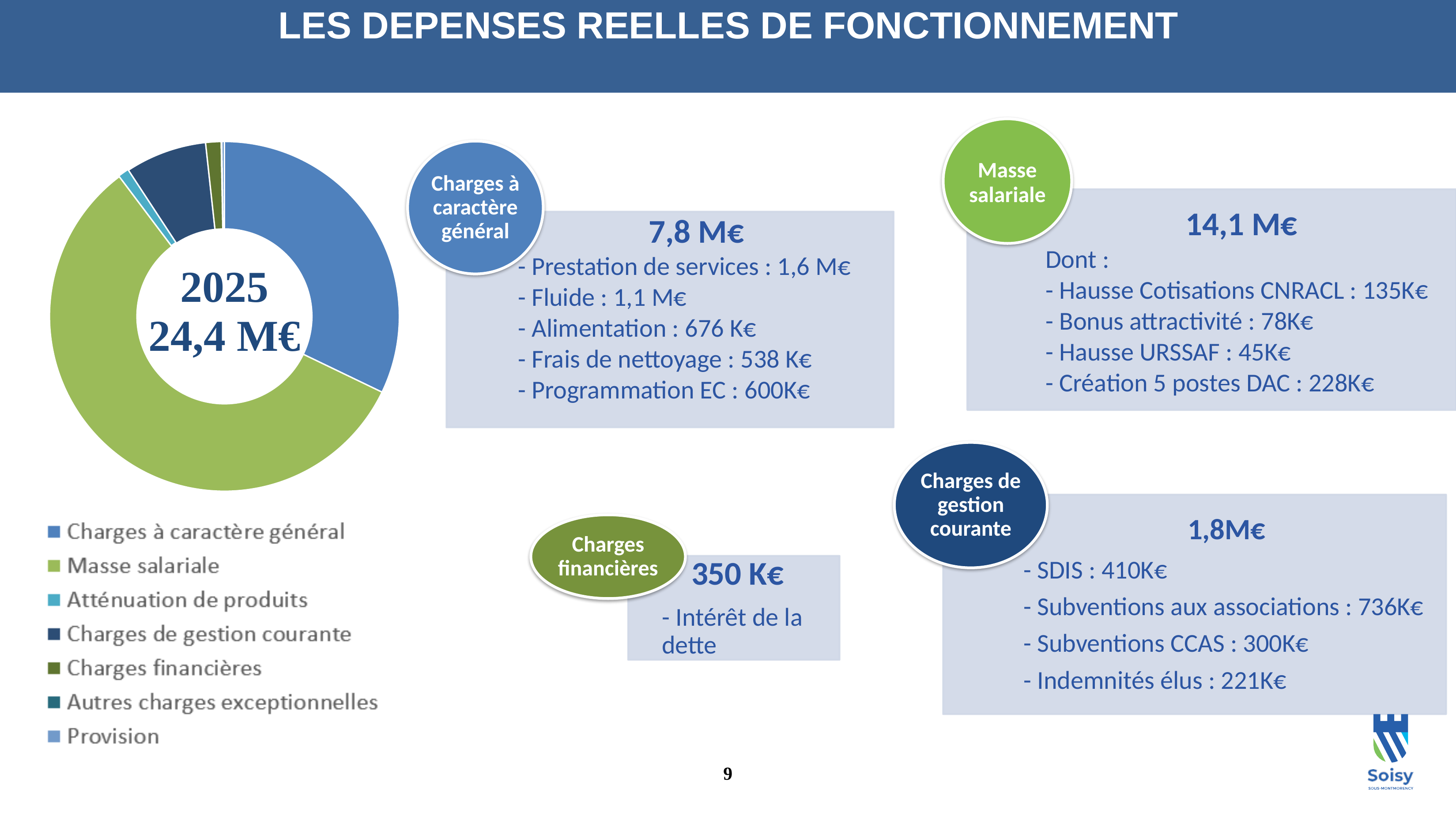
Which is larger in the doughnut chart, Charges de gestion courante or Atténuation de produits? Charges de gestion courante According to the slide, what is the amount for Charges de gestion courante in 2025? 1,8M€ How many categories does the legend of the doughnut chart list? 7 What total amount is printed in the centre of the doughnut chart? 24,4 M€ Which category takes the largest share of the doughnut chart? Masse salariale According to the slide, what is the amount for Masse salariale in 2025? 14,1 M€ What kind of chart is shown on the left of the slide? Doughnut (pie) chart According to the slide, what is the amount for Charges à caractère général in 2025? 7,8 M€ Which is larger in the doughnut chart, Masse salariale or Charges à caractère général? Masse salariale Which year is shown in the centre of the doughnut chart? 2025 Which is larger in the doughnut chart, Charges de gestion courante or Charges financières? Charges de gestion courante According to the slide, what is the amount for Charges financières in 2025? 350 K€